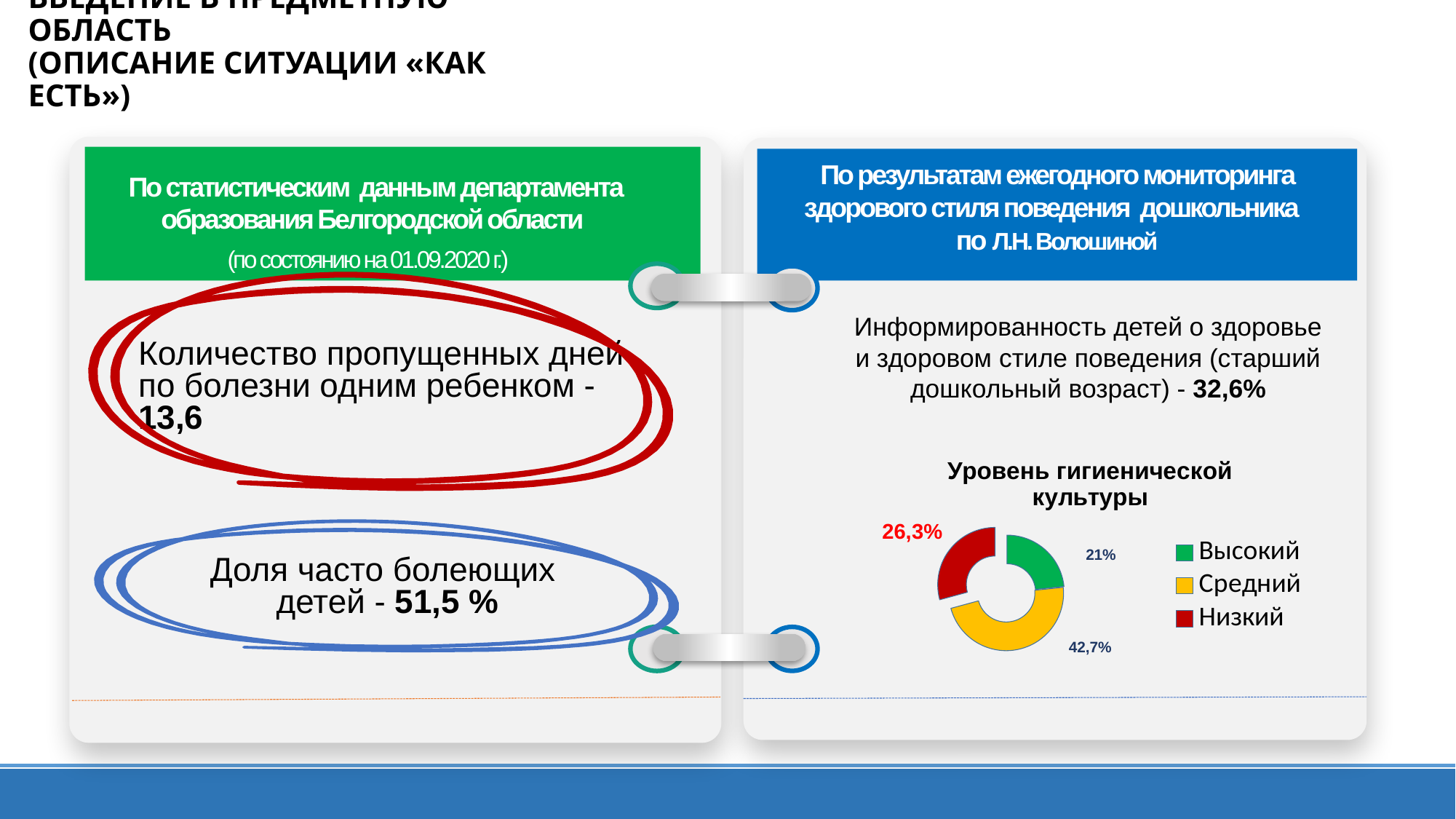
What is the value shown for the "Средний" category in the doughnut chart? 42,7% What is the title of the doughnut chart? Уровень гигиенической культуры What is the difference between the values for "Средний" and "Низкий" in the doughnut chart? 16,4% What is the value shown for the "Низкий" category in the doughnut chart? 26,3% What is the difference between the values for "Низкий" and "Высокий" in the doughnut chart? 5,3% Which category has the smallest value in the doughnut chart? Высокий How many categories does the doughnut chart show? 3 What colour represents the "Низкий" category in the doughnut chart? Red What kind of chart is shown under the title "Уровень гигиенической культуры"? Doughnut chart Which category has the largest value in the doughnut chart? Средний What is the value shown for the "Высокий" category in the doughnut chart? 21% In the doughnut chart, which is larger: the value for "Низкий" or the value for "Высокий"? Низкий